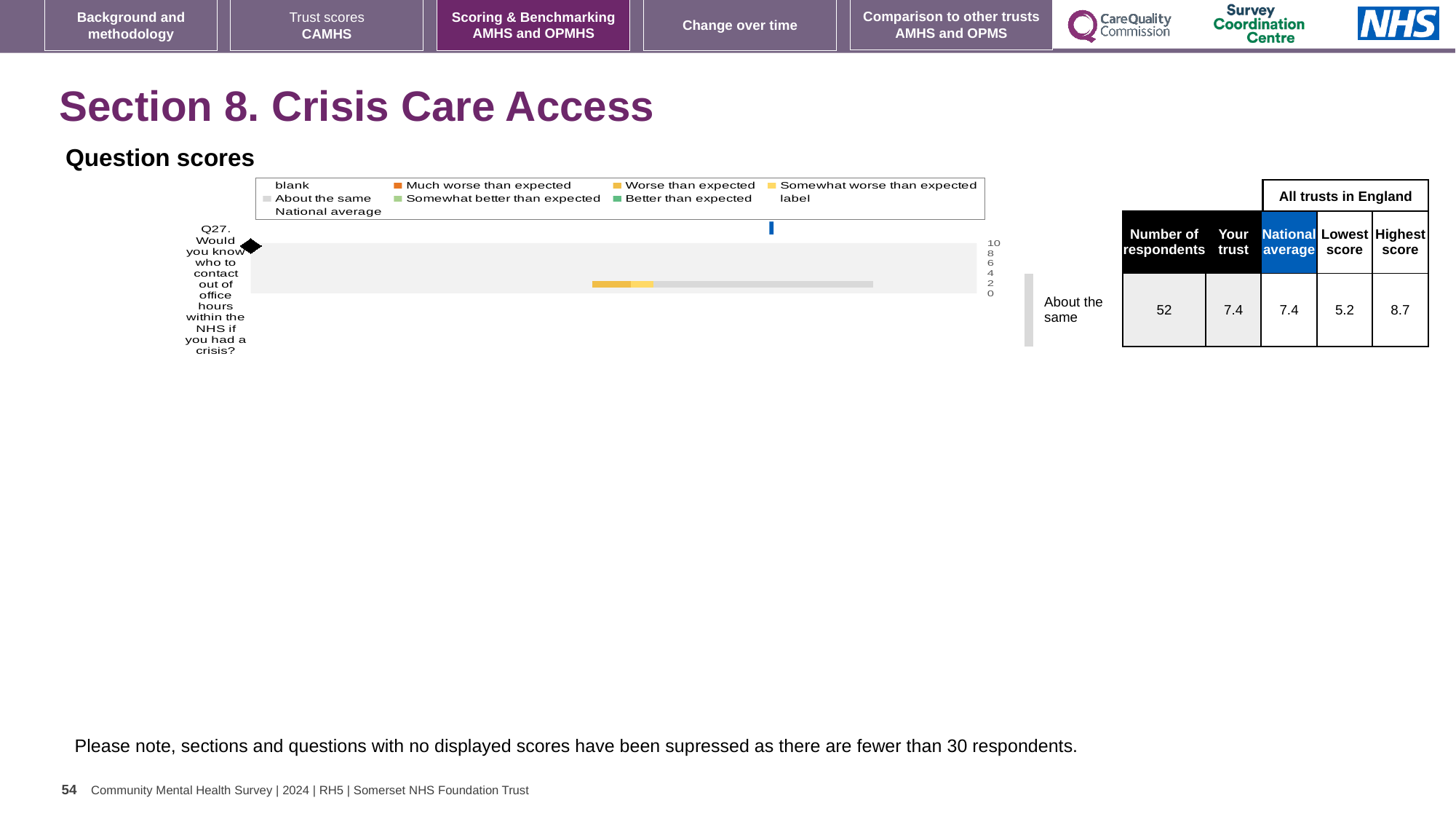
What is the difference between the highest and lowest trust scores for Q27? 3.5 What is the 'Your trust' score for Q27 (knowing who to contact out of office hours in a crisis)? 7.4 What is the highest score among all trusts in England for Q27? 8.7 Is the trust's Q27 score higher than, lower than, or the same as the national average? the same What benchmark category label is shown next to the Q27 bar? About the same What kind of chart is used to show the Q27 question score? bar chart How many questions are plotted in the Question scores chart? 1 What is the national average score for Q27? 7.4 Is the trust's Q27 score greater or less than 6 on the chart axis? greater What is the lowest score among all trusts in England for Q27? 5.2 How many respondents answered Q27? 52 By how much does the trust's Q27 score exceed the lowest score in England? 2.2